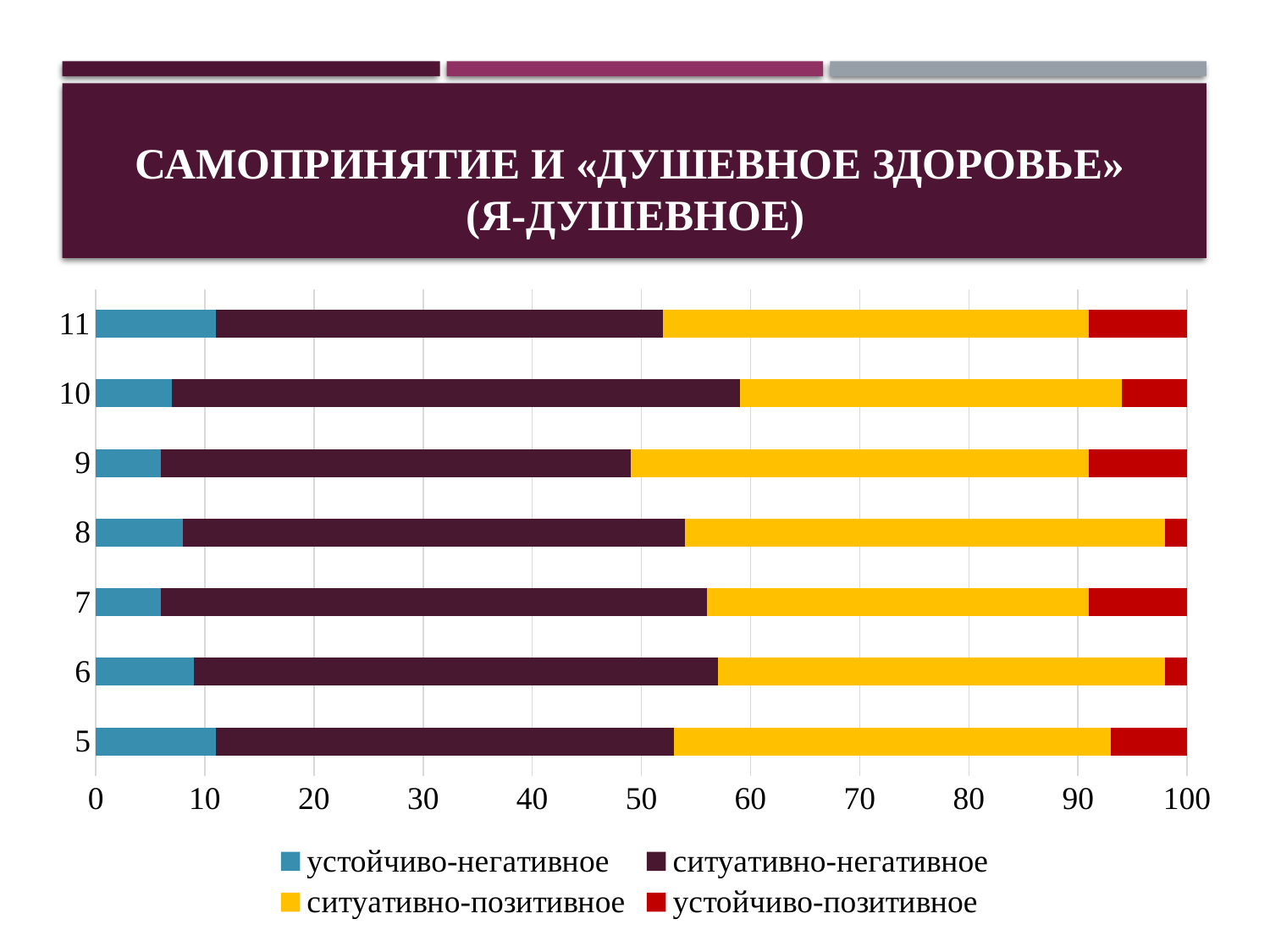
What kind of chart is shown on the slide? Stacked horizontal bar chart Is the value of устойчиво-негативное for category 10 greater or less than 10? less Which series is shown in yellow in the chart? ситуативно-позитивное Which category has the larger устойчиво-негативное value, 11 or 10? 11 Which category has the larger устойчиво-позитивное value, 11 or 8? 11 Is the value of устойчиво-позитивное for category 8 greater or less than 10? less Is the value of устойчиво-негативное for category 9 greater or less than 10? less What is the total of the stacked bar for category 11? 100 How many series does the legend list? 4 What is the title of the chart on the slide? САМОПРИНЯТИЕ И «ДУШЕВНОЕ ЗДОРОВЬЕ» (Я-ДУШЕВНОЕ) How many categories are shown on the vertical axis of the chart? 7